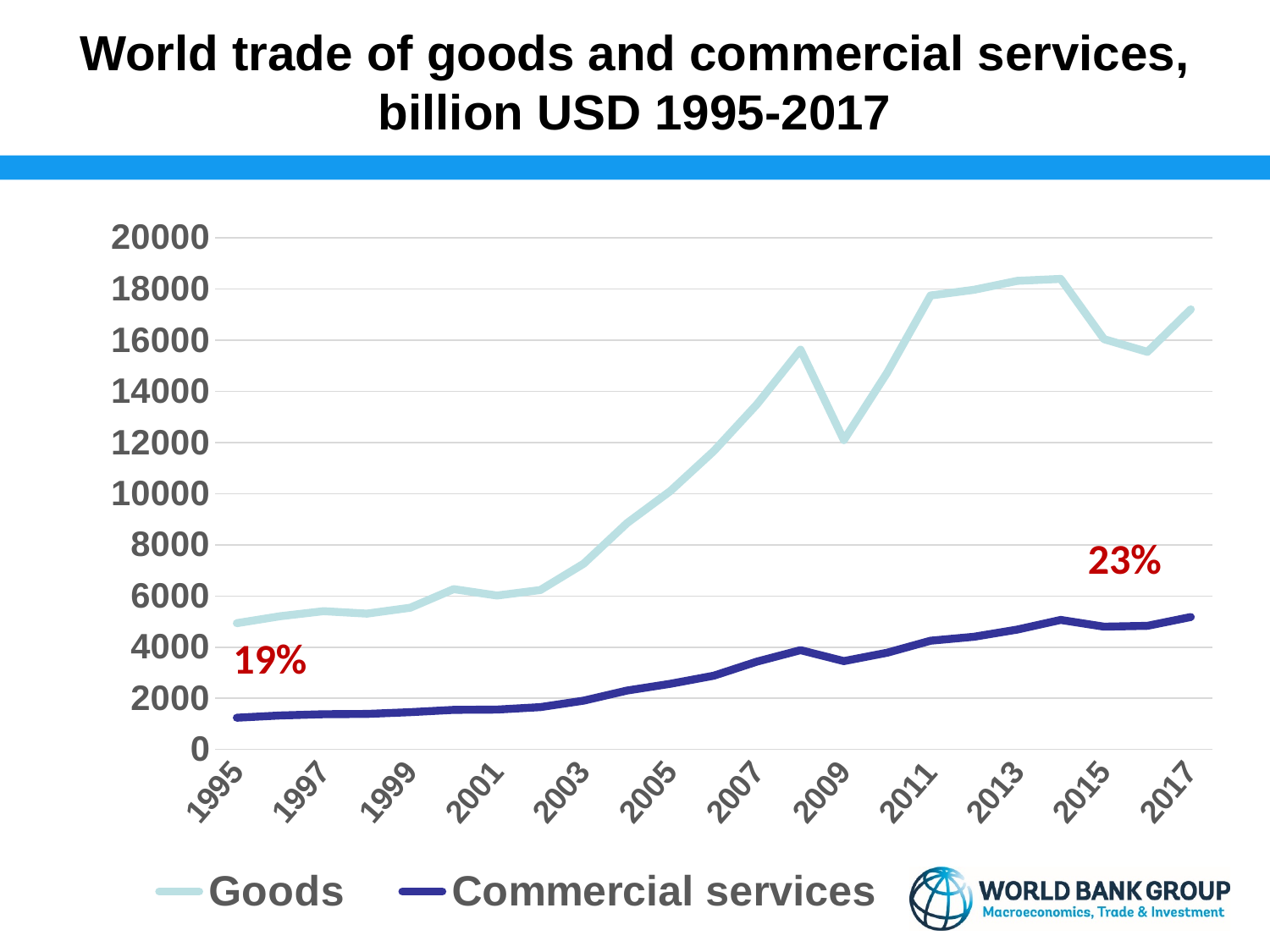
Does the Commercial services series generally rise or fall from 1995 to 2017? rise In which year is the Goods series at its lowest? 1995 What is the title of the chart? World trade of goods and commercial services, billion USD 1995-2017 What percentage label is printed near the start of the Commercial services line in 1995? 19% Is the value for Commercial services in 2017 greater or less than 4000? greater How many series does the legend list? 2 Is the value for Goods in 2008 greater or less than 14000? greater Is the value for Goods in 2014 greater or less than 16000? greater How many year labels are shown on the x axis? 12 What kind of chart is shown on the slide? line chart Which series has the larger value in 2017, Goods or Commercial services? Goods